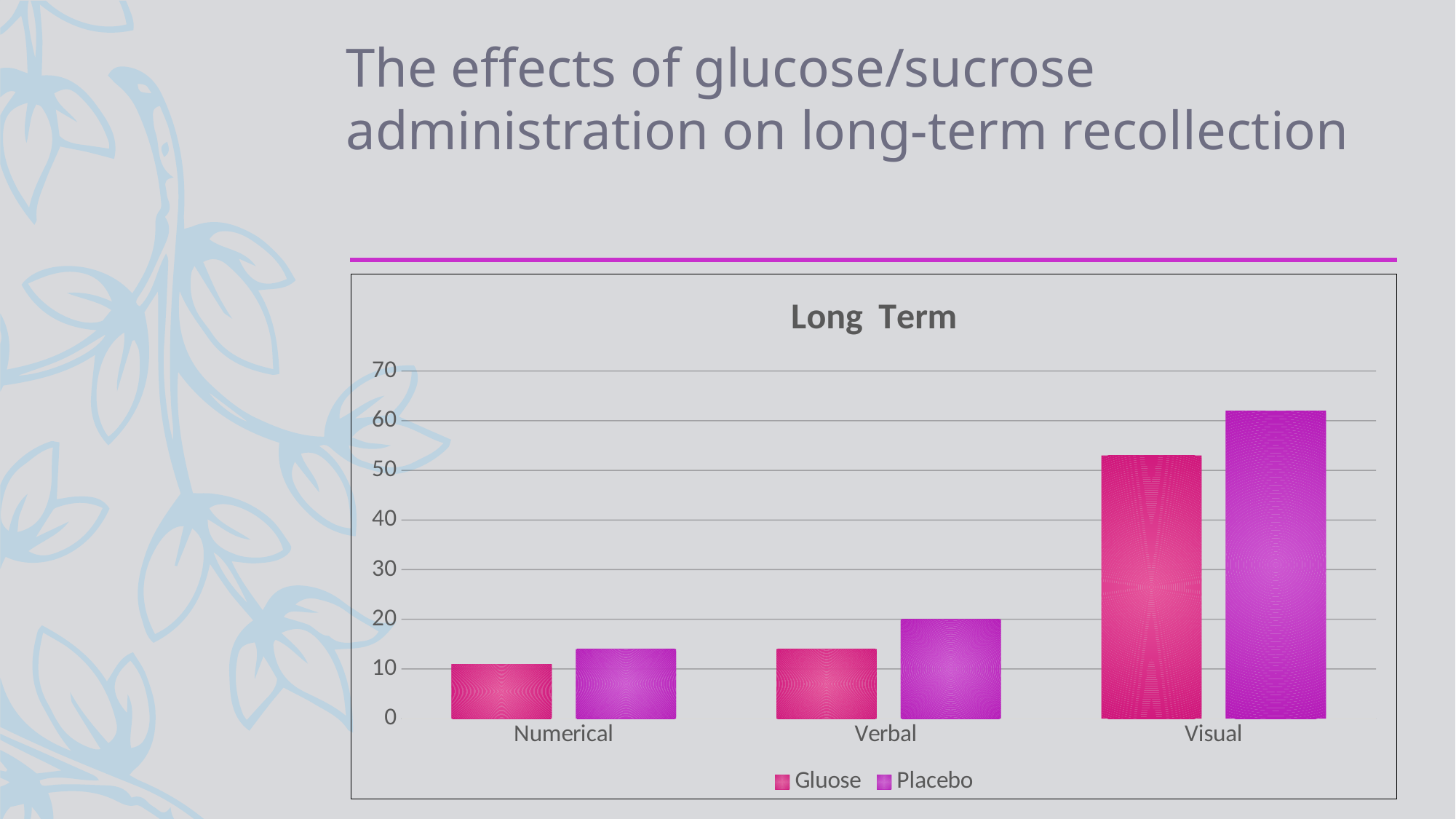
Is the Gluose value for Visual greater or less than 50? greater Is the Placebo value for Visual greater or less than 50? greater Is the Placebo value for Numerical greater or less than 20? less What is the title of the chart? Long Term Do the Gluose values rise or fall from Numerical to Visual along the x axis? Rise What kind of chart is shown on the slide? Bar chart For the Visual category, which is larger, the Gluose value or the Placebo value? Placebo How many categories are shown on the x axis? 3 Which category has the lowest Gluose value? Numerical Which category has the highest Placebo value? Visual How many series does the legend list? 2